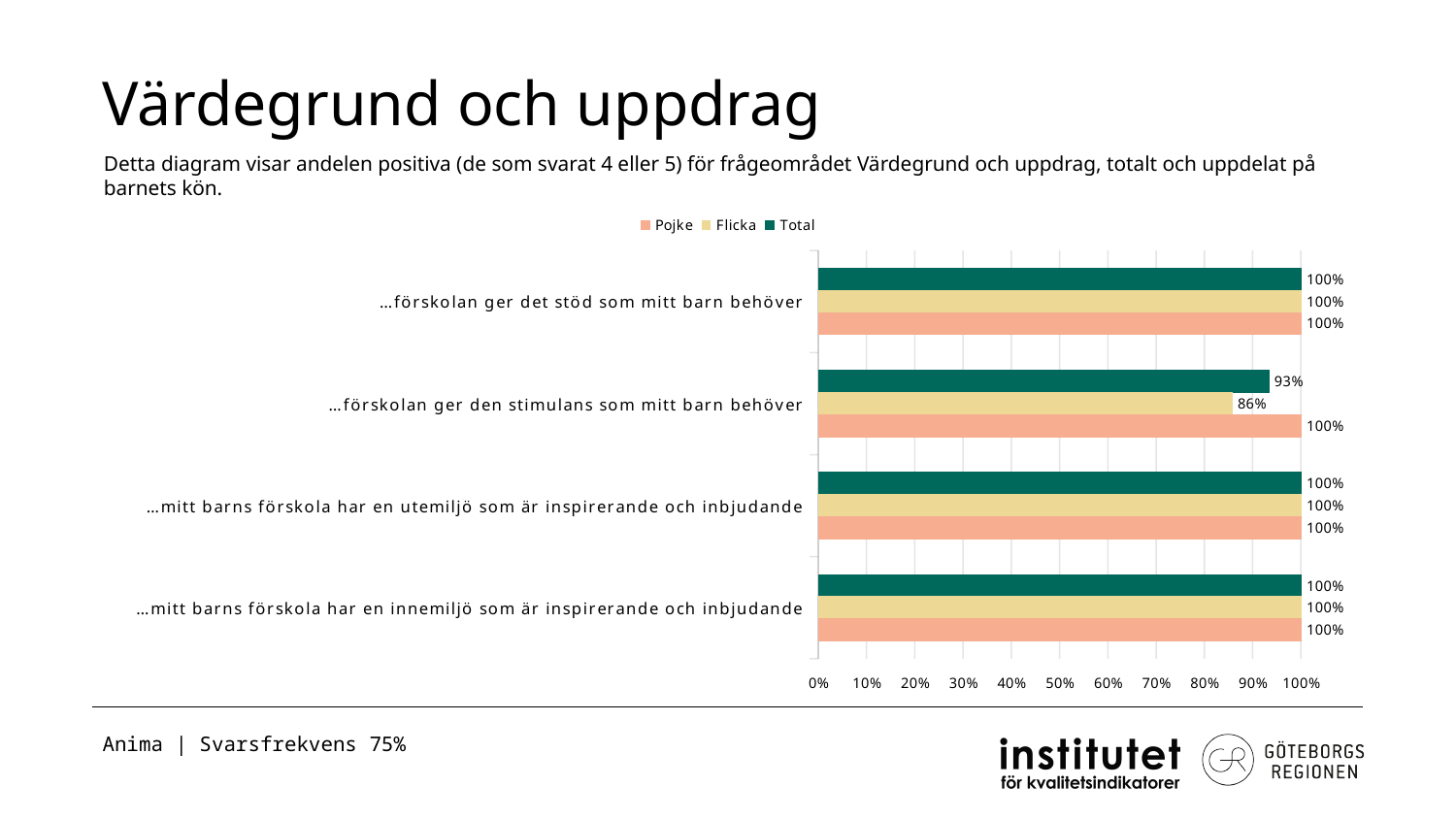
Is the Flicka value for "…förskolan ger den stimulans som mitt barn behöver" greater or less than 90%? less How many categories (statements) are shown on the y axis of the chart? 4 For "…förskolan ger den stimulans som mitt barn behöver", which is larger, the Total value or the Flicka value? Total What is the difference between the Pojke and Flicka values for "…förskolan ger den stimulans som mitt barn behöver"? 14% What kind of chart is shown on the slide? bar chart What is the Flicka value for "…förskolan ger den stimulans som mitt barn behöver"? 86% Which series is shown in green in the chart? Total Which category has the lowest Flicka value? …förskolan ger den stimulans som mitt barn behöver What is the Pojke value for "…förskolan ger den stimulans som mitt barn behöver"? 100% What is the Total value for "…förskolan ger det stöd som mitt barn behöver"? 100% How many series does the legend list? 3 What is the Total value for "…förskolan ger den stimulans som mitt barn behöver"? 93%